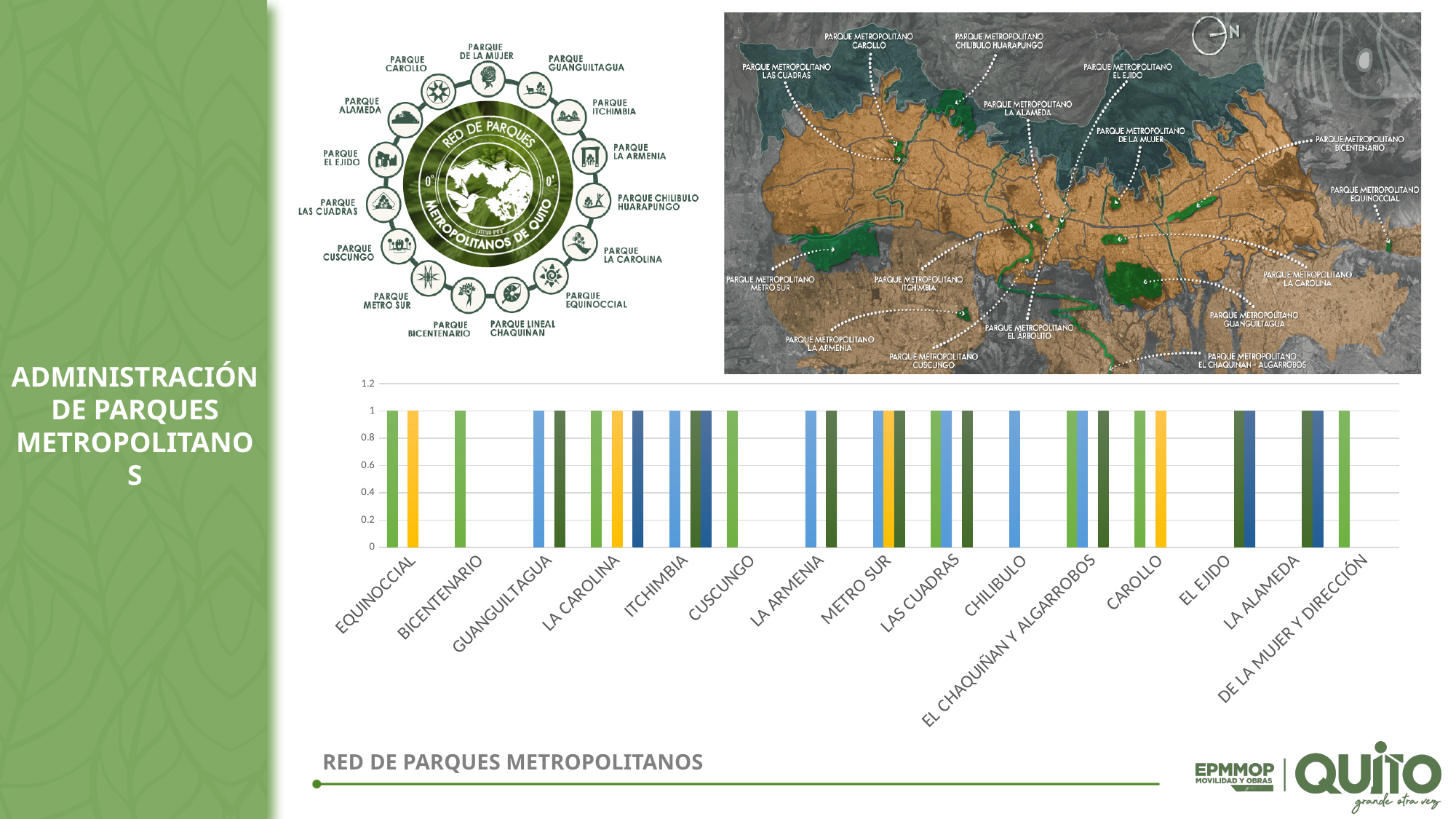
Is the value for LA CAROLINA on the bar chart greater or less than 0.8? greater How many categories are shown on the x axis of the bar chart? 15 How many bars are drawn for the category LA CAROLINA on the bar chart? 3 Is the value for EL EJIDO on the bar chart greater or less than 0.6? greater Do the bar heights rise, fall, or stay the same across the categories on the bar chart? stay the same What kind of chart is shown at the bottom of the slide? bar chart How many bars are drawn for the category EQUINOCCIAL on the bar chart? 2 What value does the bar for CHILIBULO reach on the bar chart? 1 What value do the bars for BICENTENARIO reach on the bar chart? 1 Is the value for CUSCUNGO on the bar chart greater or less than 1.2? less What is the highest tick value shown on the y axis of the bar chart? 1.2 What is the first category label on the x axis of the bar chart? EQUINOCCIAL